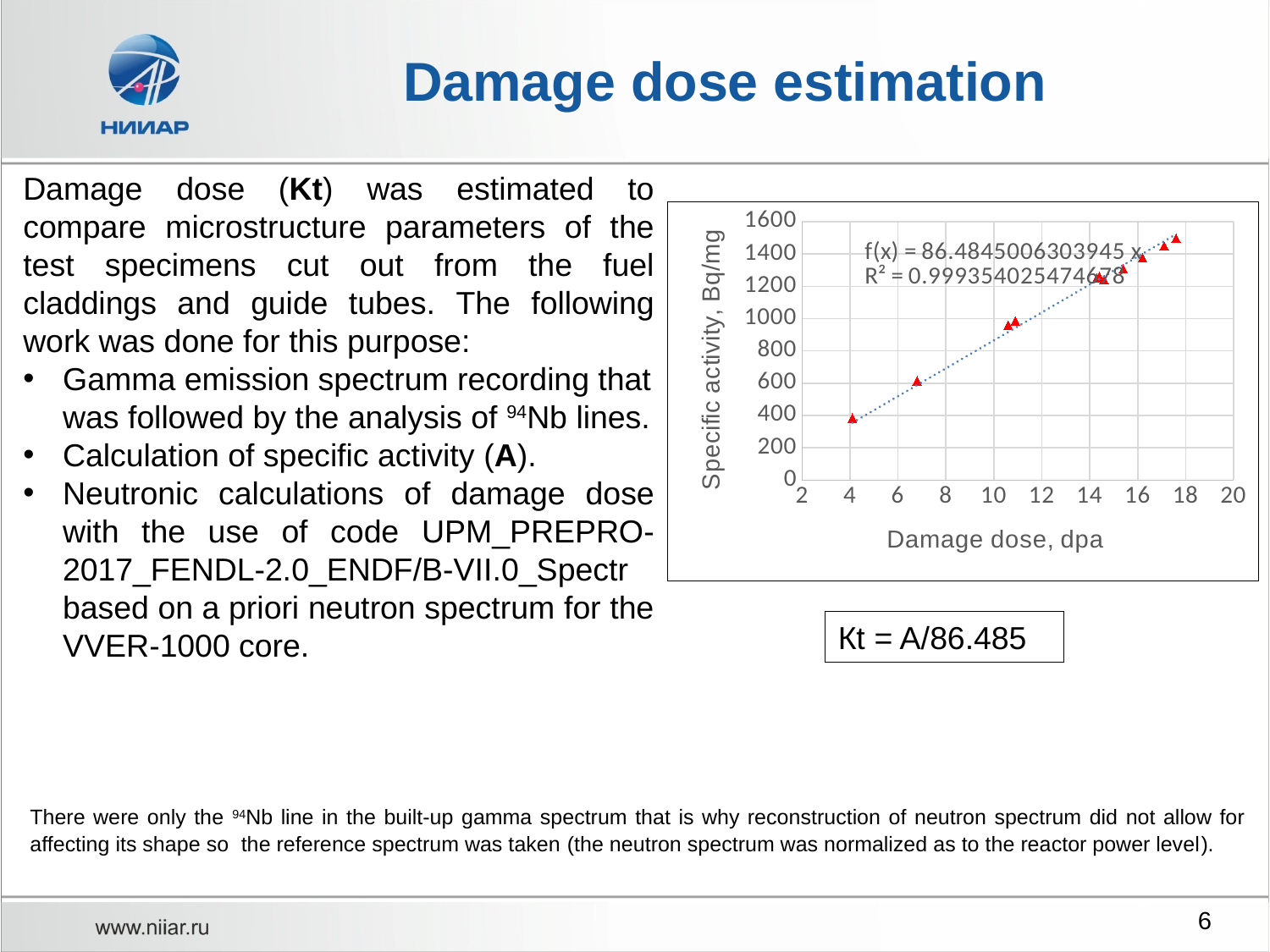
What kind of chart is shown on the slide? scatter chart Which plotted point has the higher specific activity: the one at about 4 dpa or the one at about 11 dpa? the one at about 11 dpa Is the specific activity of the lowest plotted point (at a damage dose of about 4 dpa) greater or less than 600? less What trendline equation is printed on the chart? f(x) = 86.4845006303945 x What is the maximum value shown on the y axis of the chart? 1600 What is the title of the y axis of the chart? Specific activity, Bq/mg What R² value is printed on the chart? 0.999354025474678 Is the specific activity of the point at a damage dose of about 16 dpa greater or less than 1200? greater Is the specific activity of the point at a damage dose of about 7 dpa greater or less than 800? less Do the plotted values of specific activity rise or fall as damage dose increases along the x axis? rise What is the title of the x axis of the chart? Damage dose, dpa